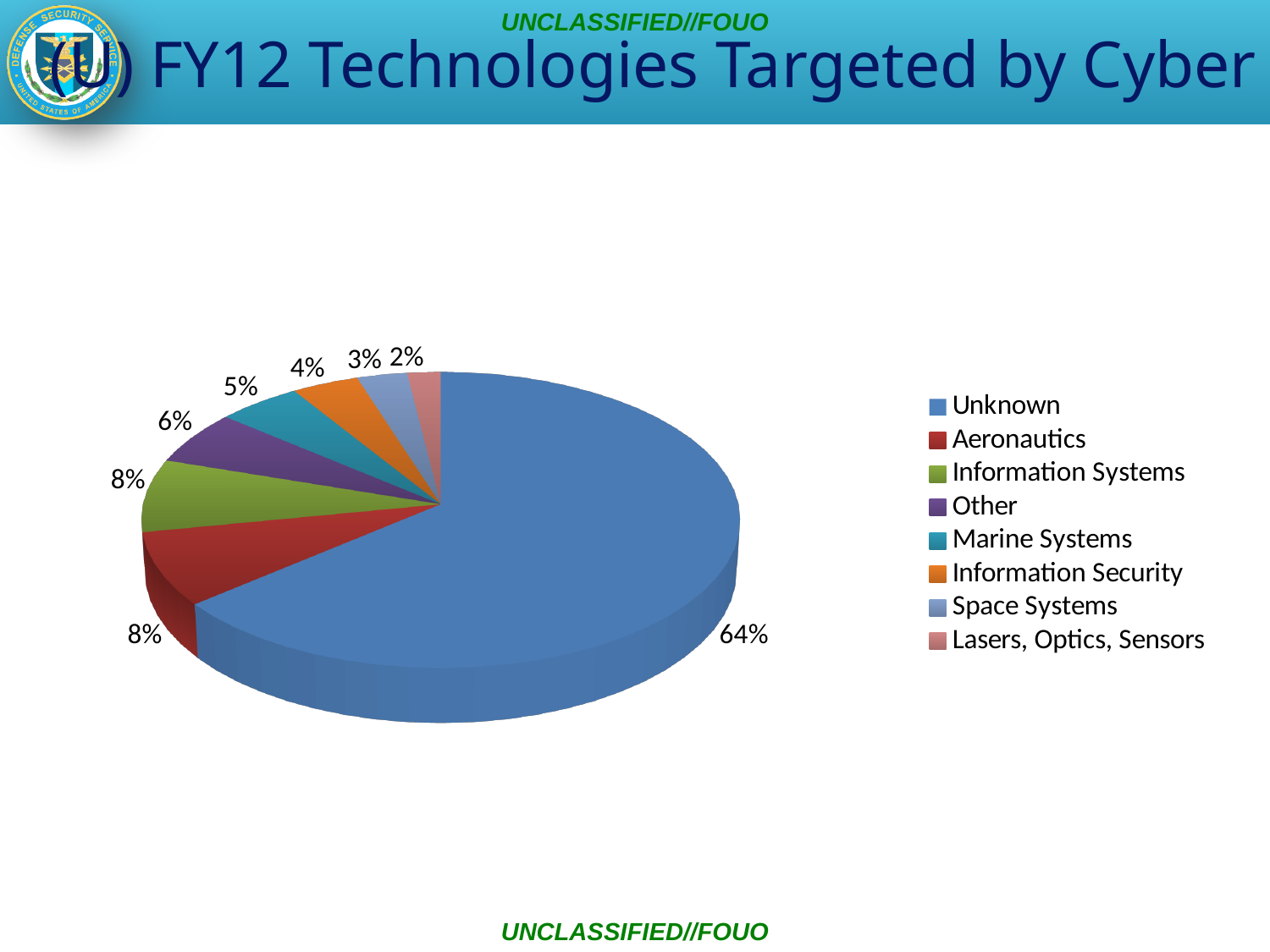
What kind of chart is shown on the slide? Pie chart What percentage is shown for Lasers, Optics, Sensors? 2% What percentage is shown for Aeronautics? 8% Which category has the largest slice of the pie? Unknown What percentage is shown for Other? 6% How many categories does the legend list? 8 What is the difference in percentage points between Unknown and Information Systems? 56 Which category has the smallest slice of the pie? Lasers, Optics, Sensors What share of the pie does Unknown account for? 64% Which is larger, the share for Marine Systems or the share for Space Systems? Marine Systems What percentage is shown for Marine Systems? 5% What percentage is shown for Information Security? 4%